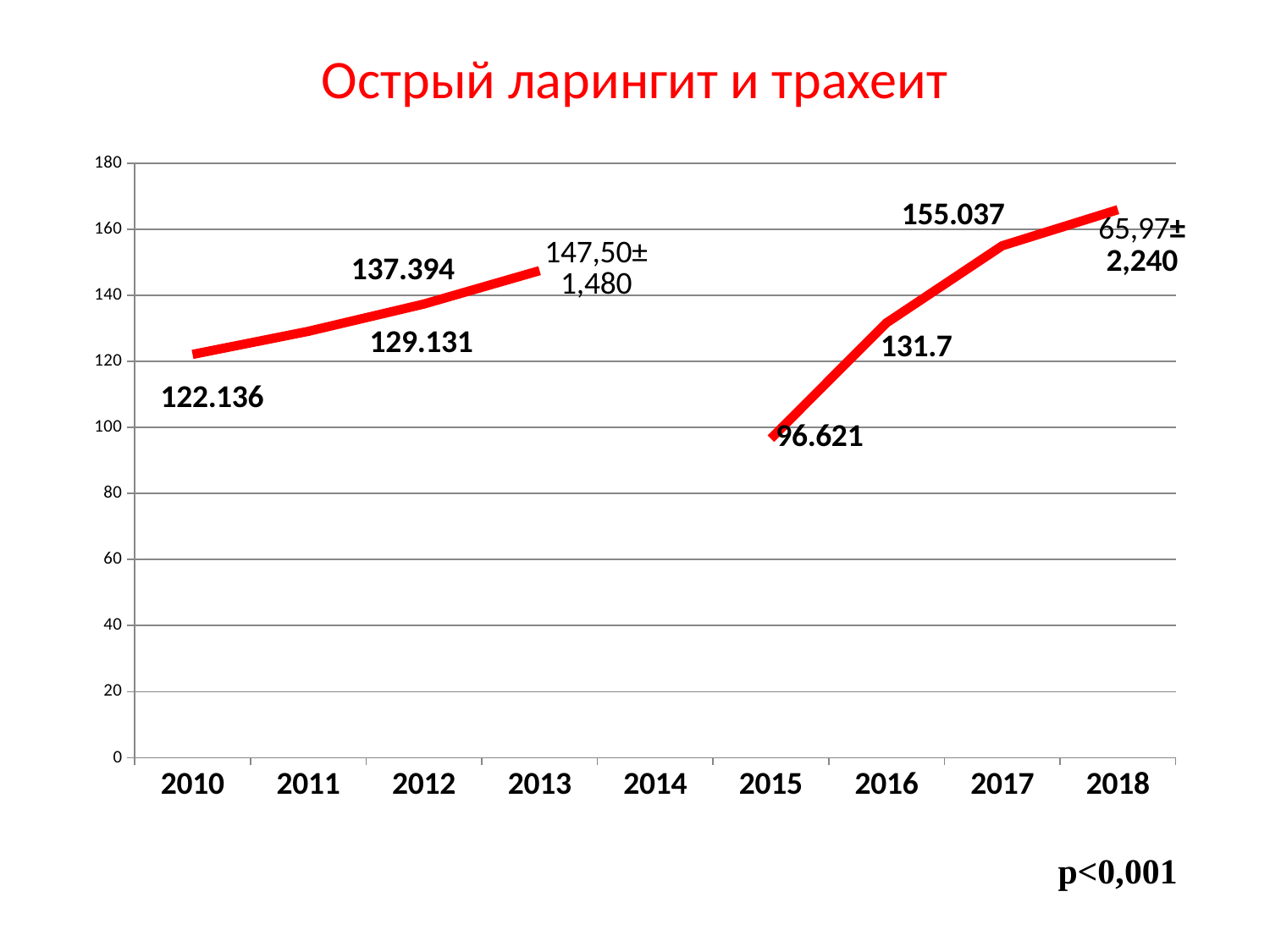
What is the value for 2017? 155.037 Which is larger, the value for 2011 or the value for 2016? 2016 Is the value for 2018 greater or less than 160? greater What is the difference between the values for 2017 and 2010? 32.901 What is the value for 2015? 96.621 What is the value for 2012? 137.394 What kind of chart is shown on the slide? line chart What is the title of the chart? Острый ларингит и трахеит What is the value for 2010? 122.136 Which year has the lowest value on the chart? 2015 Which year has the highest value on the chart? 2018 Do the values rise or fall from 2015 to 2018? rise